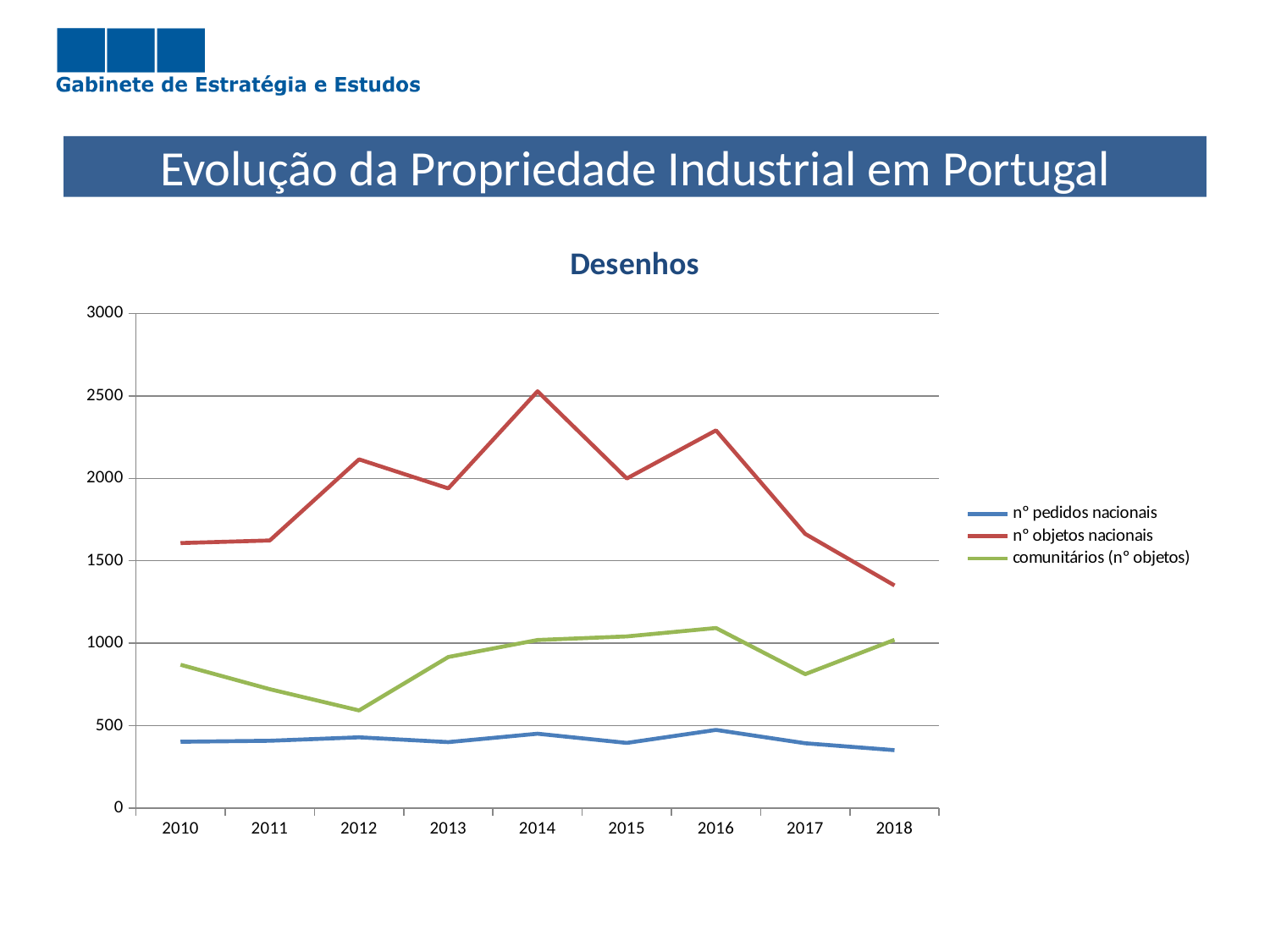
Does the 'nº objetos nacionais' series rise or fall from 2016 to 2018? fall Is the value for 'nº pedidos nacionais' in 2016 greater or less than 500? less How many years are shown on the x axis? 9 Which is larger for 'nº objetos nacionais': the value in 2012 or the value in 2013? 2012 How many series does the legend list? 3 Is the value for 'comunitários (nº objetos)' in 2012 greater or less than 1000? less What kind of chart is shown on the slide? line chart In which year is the 'comunitários (nº objetos)' series at its lowest? 2012 In which year does the 'nº objetos nacionais' series reach its lowest value? 2018 Is the value for 'nº objetos nacionais' in 2018 greater or less than 1500? less What is the title of the chart? Desenhos In which year does the 'nº objetos nacionais' series reach its highest value? 2014